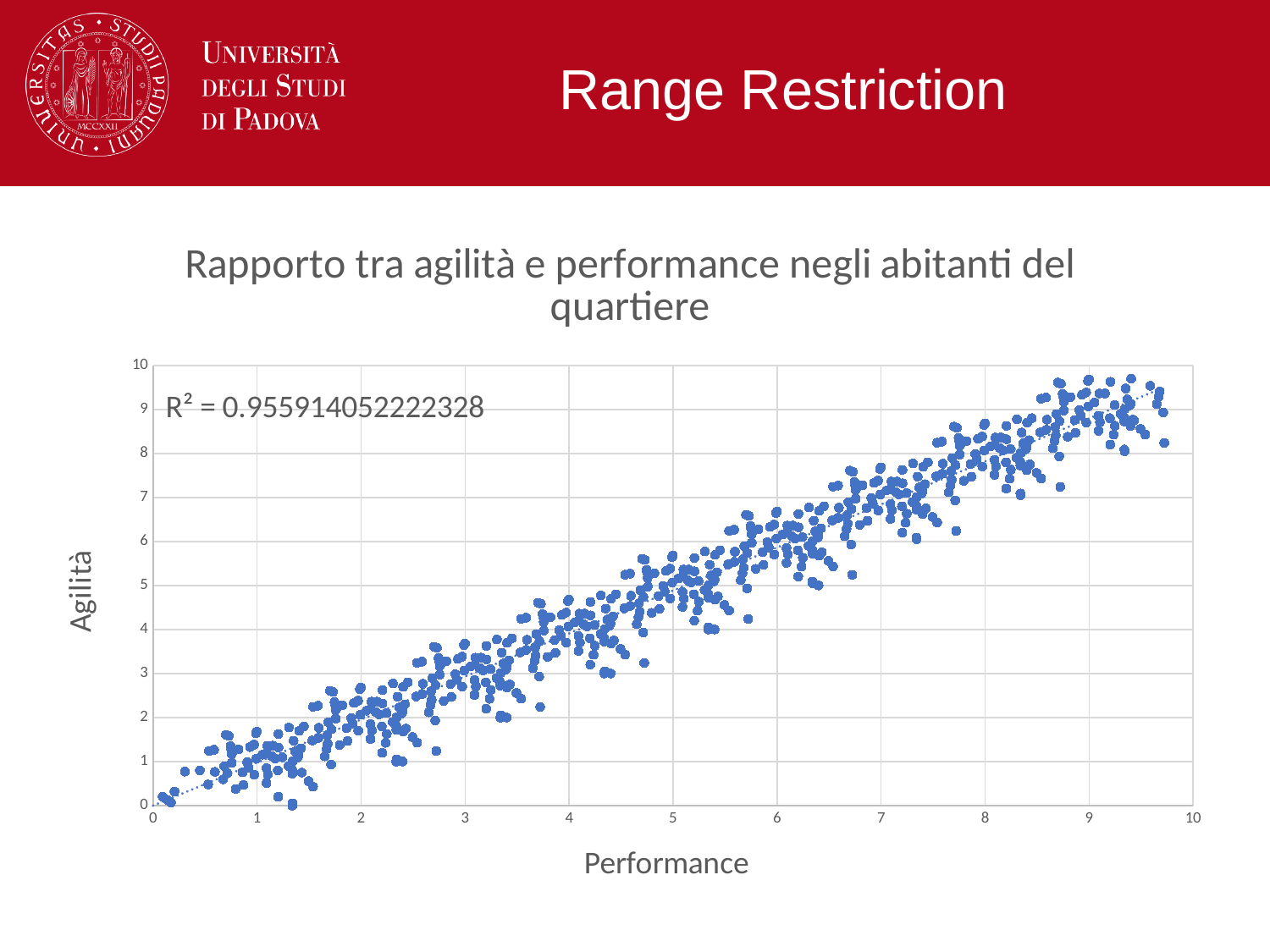
What are the labels of the x axis and the y axis of the chart? Performance (x axis) and Agilità (y axis) What is the title of the chart? Rapporto tra agilità e performance negli abitanti del quartiere As Performance increases along the x axis, does Agilità tend to rise or fall? rise What kind of chart is shown on the slide? scatter plot Is the R² value printed on the chart greater or less than 0.9? greater What R² value is printed on the chart? R² = 0.955914052222328